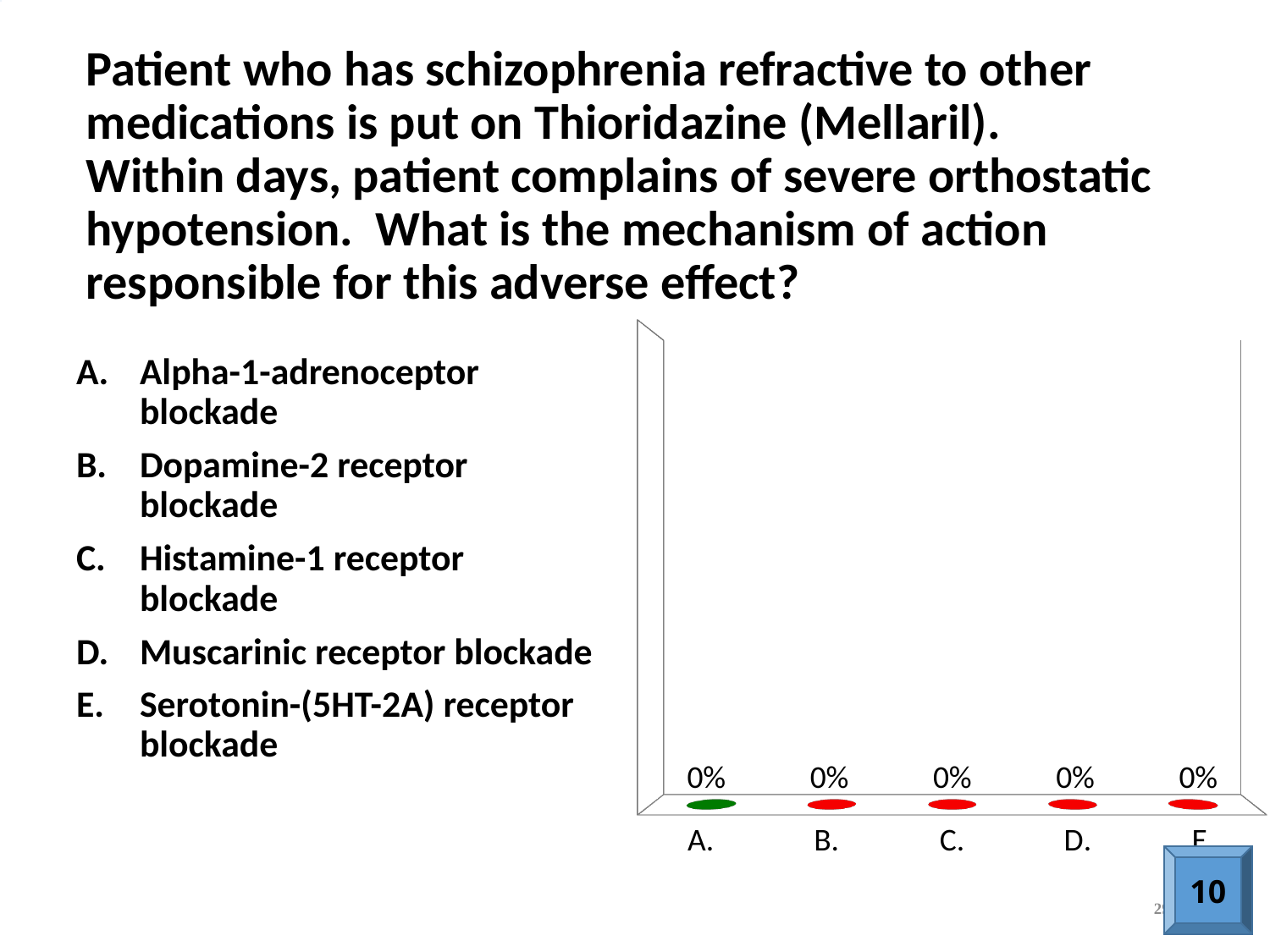
What type of chart is shown on the slide? bar chart Is the value for category C. larger than, smaller than, or equal to the value for category D.? equal What is the value shown for category D. in the chart? 0% What is the value shown for category A. in the chart? 0% What colour is the marker for category A. in the chart? green What is the value shown for category C. in the chart? 0% Do the values rise, fall, or stay the same from category A. to category D.? stay the same What is the difference between the values for category A. and category B.? 0% What is the value shown for category B. in the chart? 0% How many categories are plotted in the chart? 5 What colour are the markers for categories B., C. and D. in the chart? red